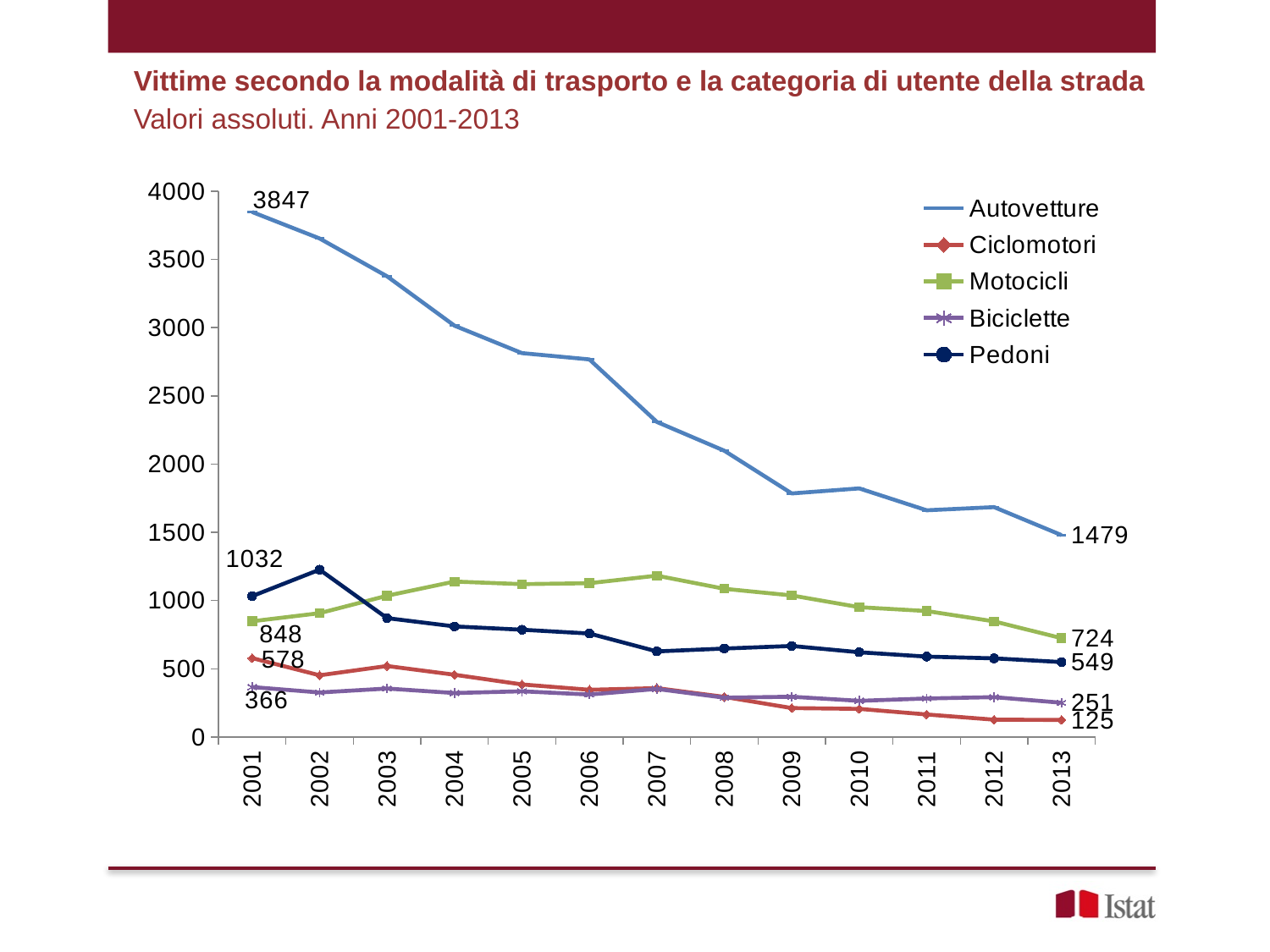
Which is larger in 2013, the value for Pedoni or the value for Biciclette? Pedoni What is the value for Autovetture in 2001? 3847 What is the difference between the Autovetture values in 2001 and 2013? 2368 Is the value for Autovetture in 2007 greater or less than 2500? less What is the value for Ciclomotori in 2013? 125 How many series does the legend list? 5 What is the value for Autovetture in 2013? 1479 What is the value for Motocicli in 2013? 724 Which series has the highest value in 2001? Autovetture What is the value for Pedoni in 2001? 1032 What kind of chart is shown on the slide? line chart Which series has the lowest value in 2013? Ciclomotori